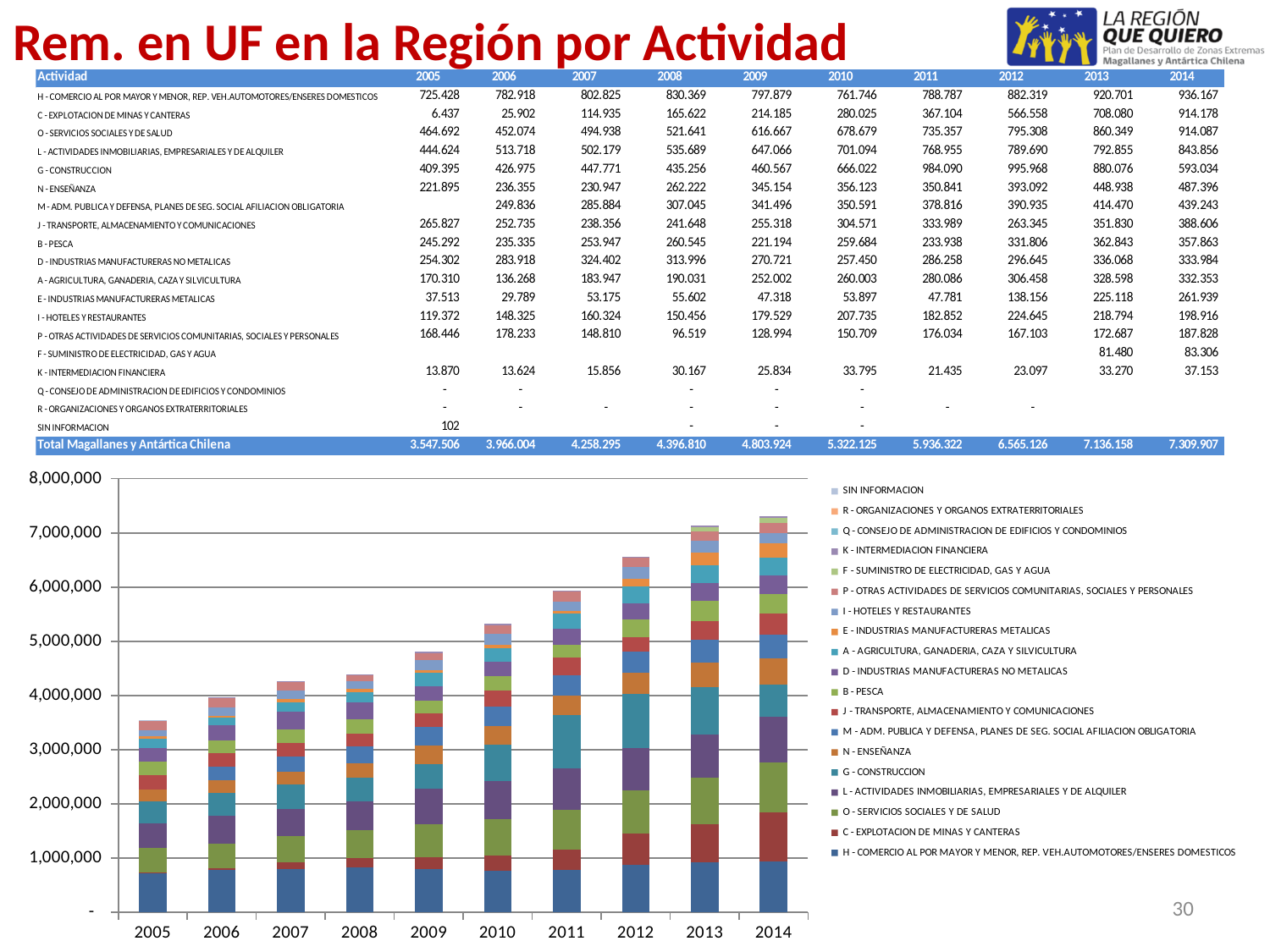
Which year has the tallest stacked bar? 2014 What kind of chart is shown on the slide? stacked bar chart Do the stacked bar totals rise or fall from 2005 to 2014? rise Is the total for 2014 greater or less than 7,000,000? greater According to the table on the slide, what is the total for Magallanes y Antártica Chilena in 2014? 7.309.907 How many years are shown along the x axis of the chart? 10 Which year has the larger stacked bar, 2012 or 2009? 2012 Which year has the shortest stacked bar? 2005 Which series is plotted at the bottom of each stacked bar (the blue segment)? H - COMERCIO AL POR MAYOR Y MENOR, REP. VEH.AUTOMOTORES/ENSERES DOMESTICOS Is the total for 2005 greater or less than 4,000,000? less How many series does the chart legend list? 19 Is the total for 2010 greater or less than 5,000,000? greater